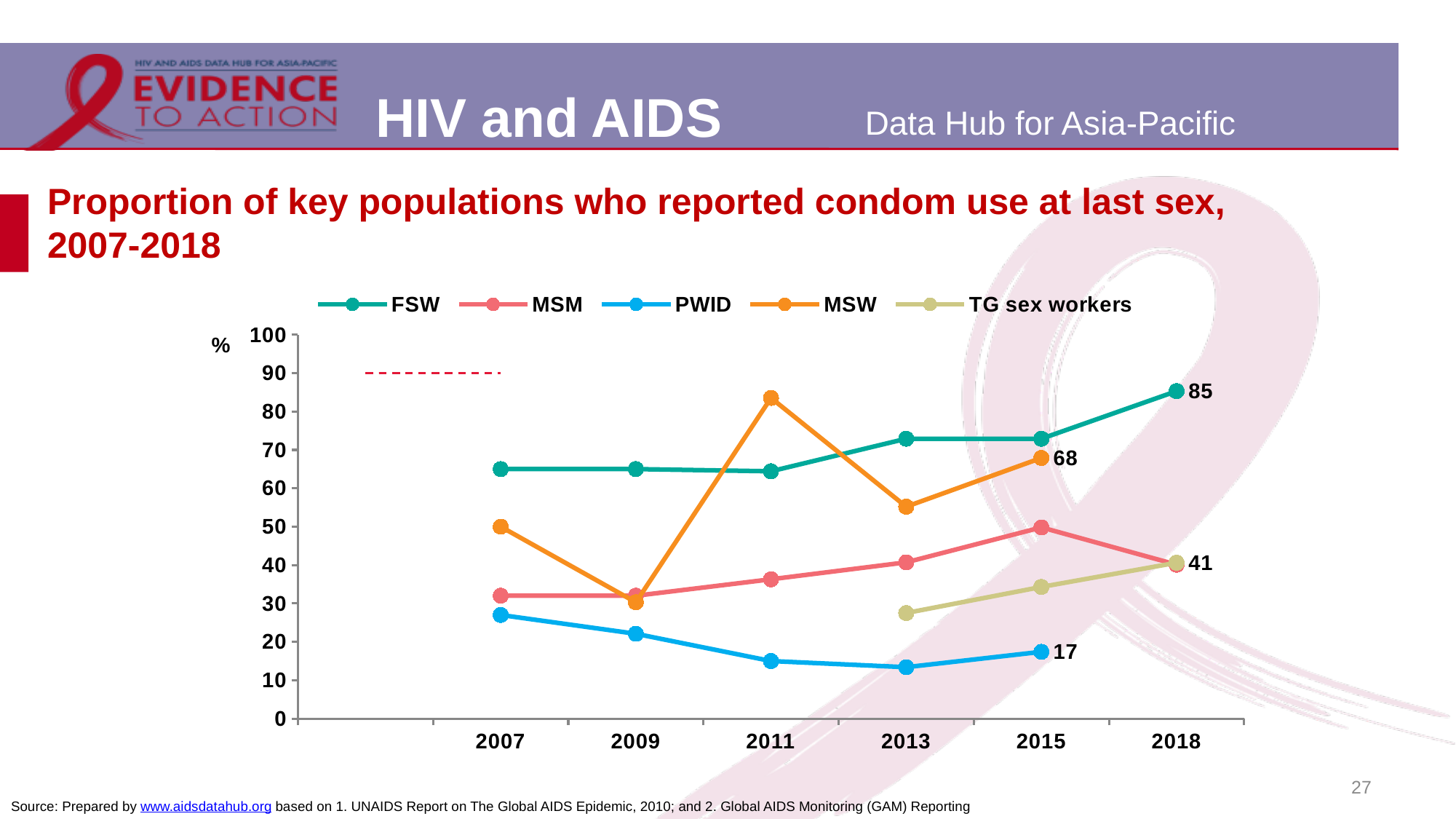
Is the value for MSW in 2011 greater or less than 80? greater What is the difference between the labelled FSW value in 2018 (85) and the labelled TG sex workers value in 2018 (41)? 44 Which series has the highest value in 2018? FSW What value is labelled for PWID in 2015? 17 How many years are shown on the x axis? 6 Does the PWID line rise or fall from 2007 to 2013? Falls How many series does the legend list? 5 What value is labelled for MSW in 2015? 68 What value is labelled for FSW in 2018? 85 In 2013, which is higher: FSW or MSM? FSW Is the value for PWID in 2011 greater or less than 20? less What kind of chart is shown on the slide? Line chart